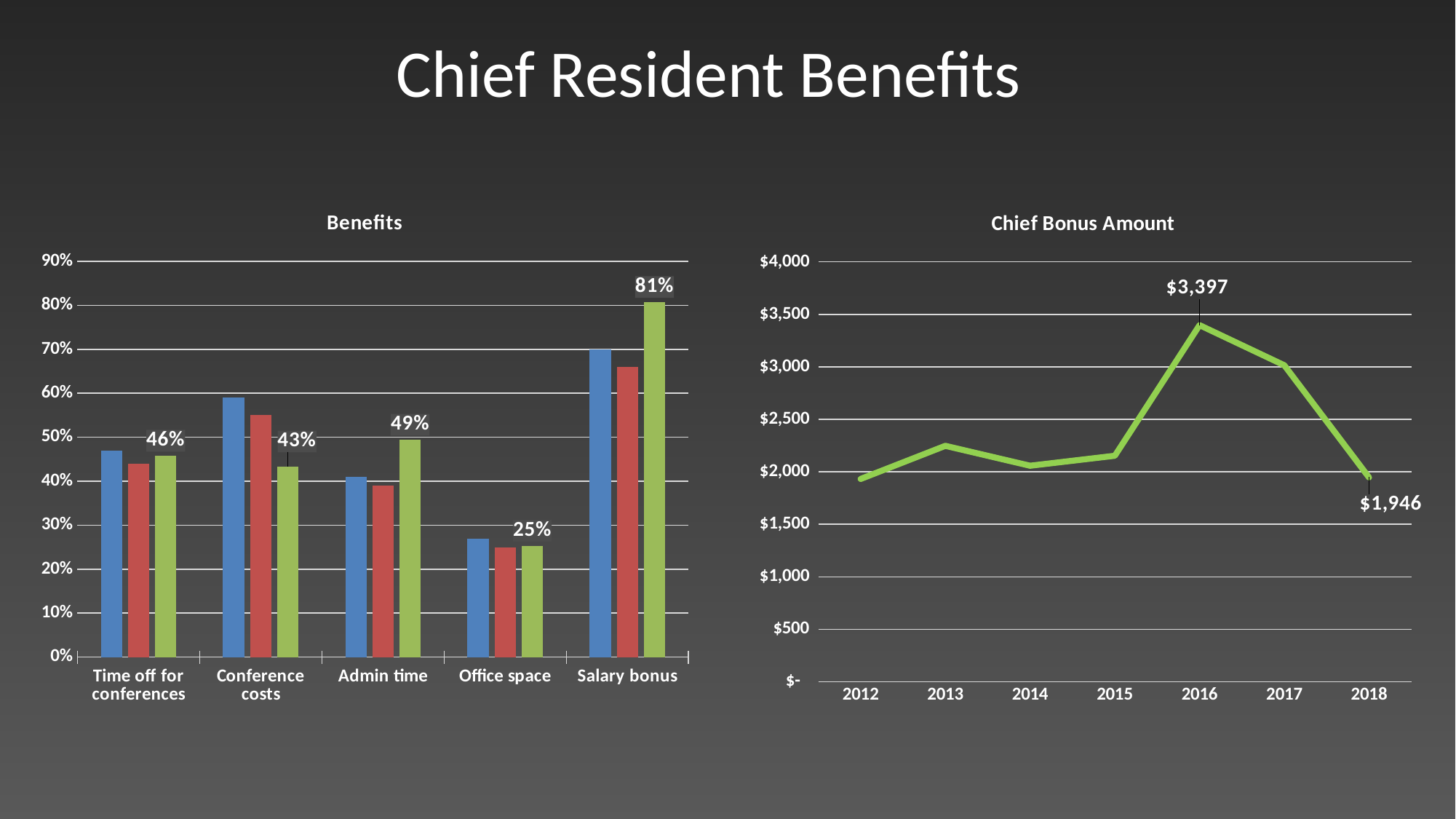
In the Chief Bonus Amount chart, what is the labelled value for 2018? $1,946 How many categories are shown on the x axis of the Benefits chart? 5 In the Benefits chart, what is the difference between the green bar values for Salary bonus and Office space? 56% In the Benefits chart, what is the labelled value of the green bar for Office space? 25% In the Chief Bonus Amount chart, what is the labelled value for 2016? $3,397 In the Benefits chart, what is the labelled value of the green bar for Admin time? 49% What kind of chart is the Chief Bonus Amount chart? line chart In the Benefits chart, is the blue bar for Conference costs greater or less than 50%? greater In the Benefits chart, what is the labelled value of the green bar for Salary bonus? 81% In the Benefits chart, which category has the highest green bar? Salary bonus In the Benefits chart, which category has the lowest green bar? Office space In the Chief Bonus Amount chart, which year has the highest value? 2016